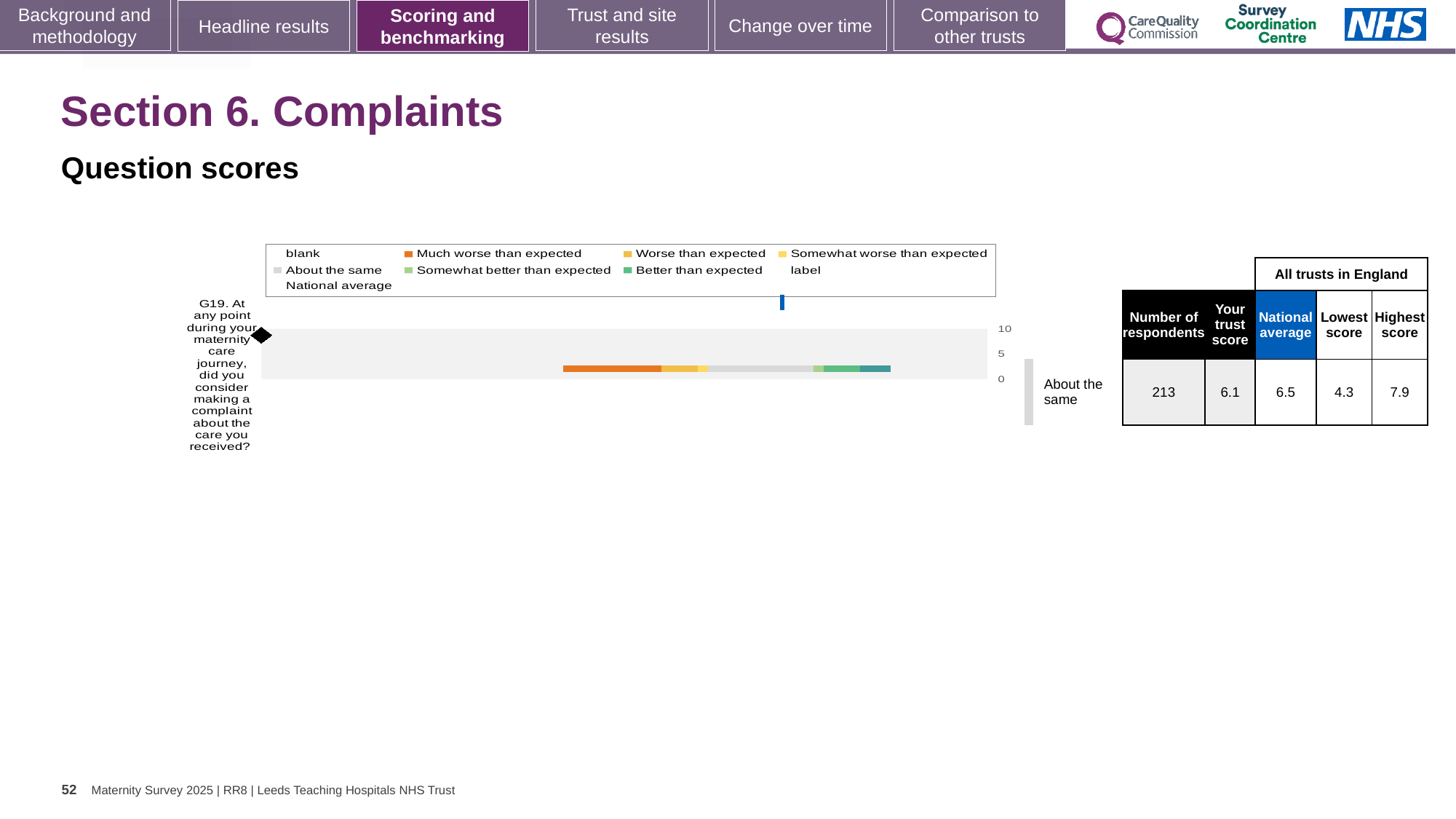
How many respondents answered question G19? 213 What is the highest score among all trusts in England for question G19? 7.9 What kind of chart is shown on the slide? bar chart Which benchmark category is the trust's score for question G19 placed in? About the same How many survey questions are plotted in the chart? 1 How many entries does the chart legend list? 9 What is the difference between the highest score and the lowest score for question G19? 3.6 What is the national average score for question G19? 6.5 What is the lowest score among all trusts in England for question G19? 4.3 What is the trust score for question G19? 6.1 Which survey question is plotted in the chart? G19. At any point during your maternity care journey, did you consider making a complaint about the care you received? Which is larger for question G19, the trust score or the national average? National average